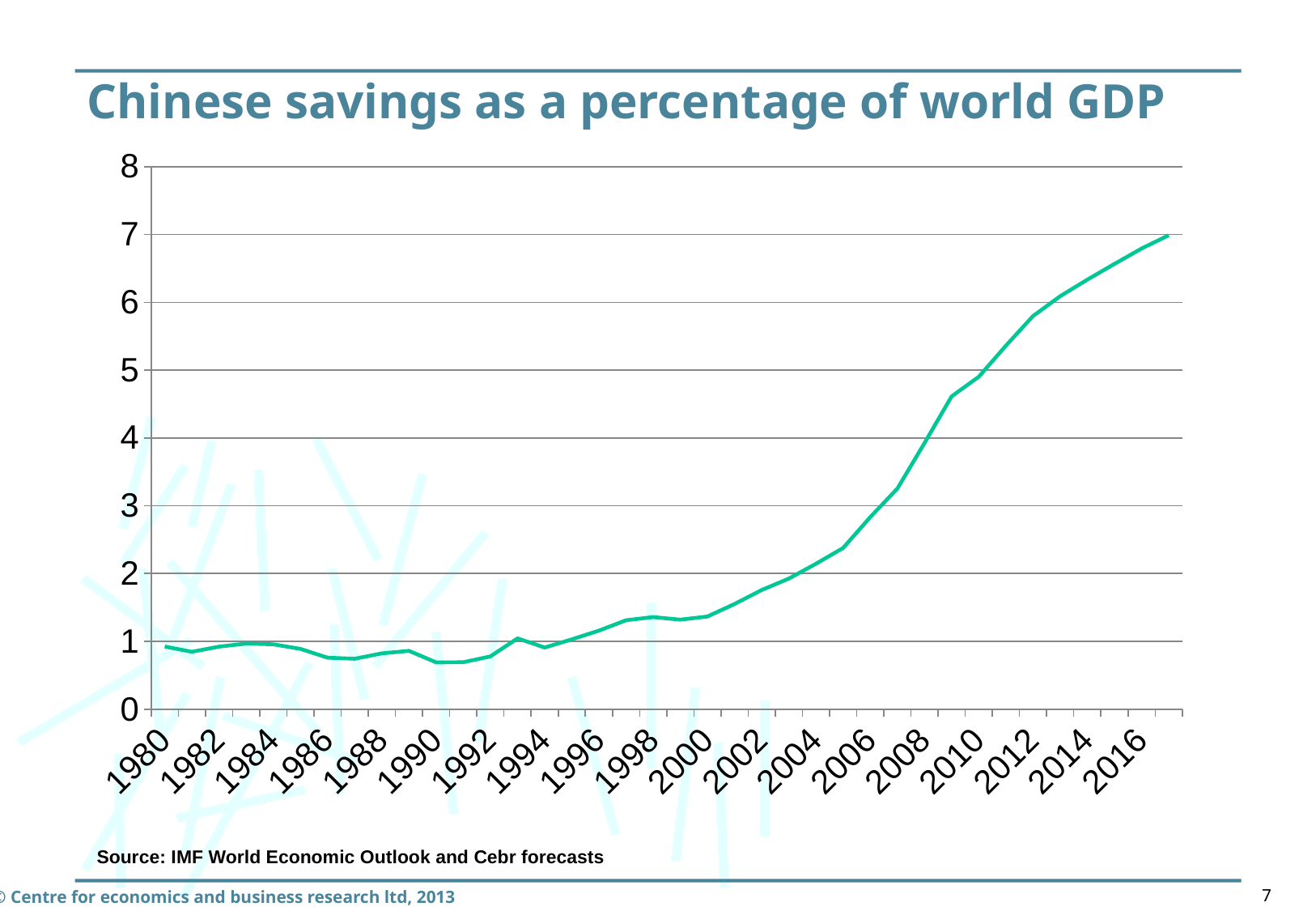
How many year labels are shown on the x axis? 19 What is the title of the chart? Chinese savings as a percentage of world GDP What source is cited below the chart? IMF World Economic Outlook and Cebr forecasts Is the value for 2016 greater or less than 6? greater Is the value for 1990 greater or less than 1? less Is the value for 2010 greater or less than 4? greater Does the line rise or fall between 2000 and 2016? rise What kind of chart is shown on the slide? line chart Which year has a larger value, 1980 or 2016? 2016